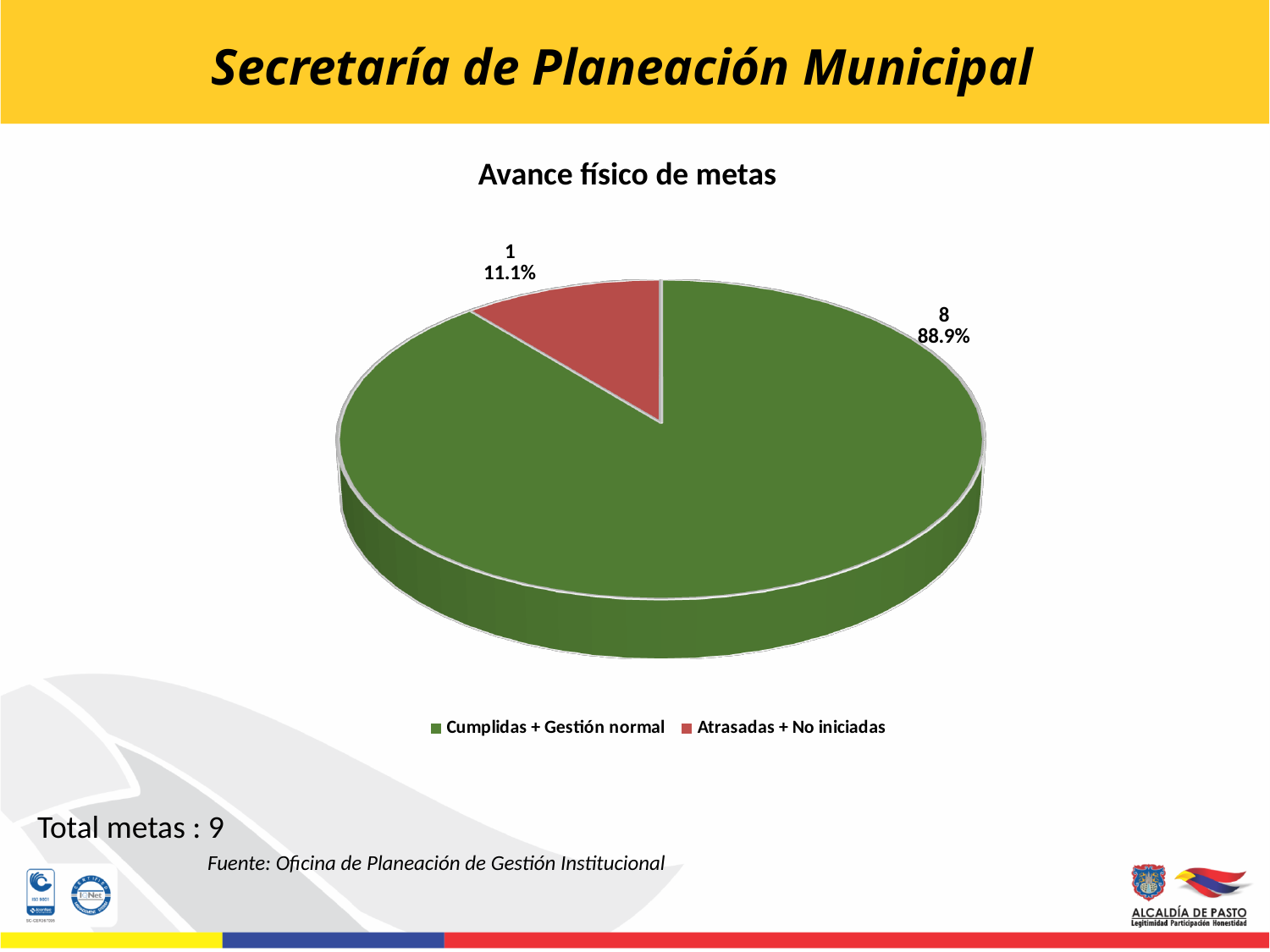
What colour is the slice for Atrasadas + No iniciadas? red How many entries does the legend list? 2 What kind of chart is shown on the slide? pie chart What share of the pie does Cumplidas + Gestión normal represent? 88.9% What is the value for Cumplidas + Gestión normal? 8 What share of the pie does Atrasadas + No iniciadas represent? 11.1% What is the value for Atrasadas + No iniciadas? 1 What is the title of the chart? Avance físico de metas What is the difference between the values for Cumplidas + Gestión normal and Atrasadas + No iniciadas? 7 Which category has the largest slice? Cumplidas + Gestión normal Which category has the smallest slice? Atrasadas + No iniciadas How many slices does the pie chart have? 2